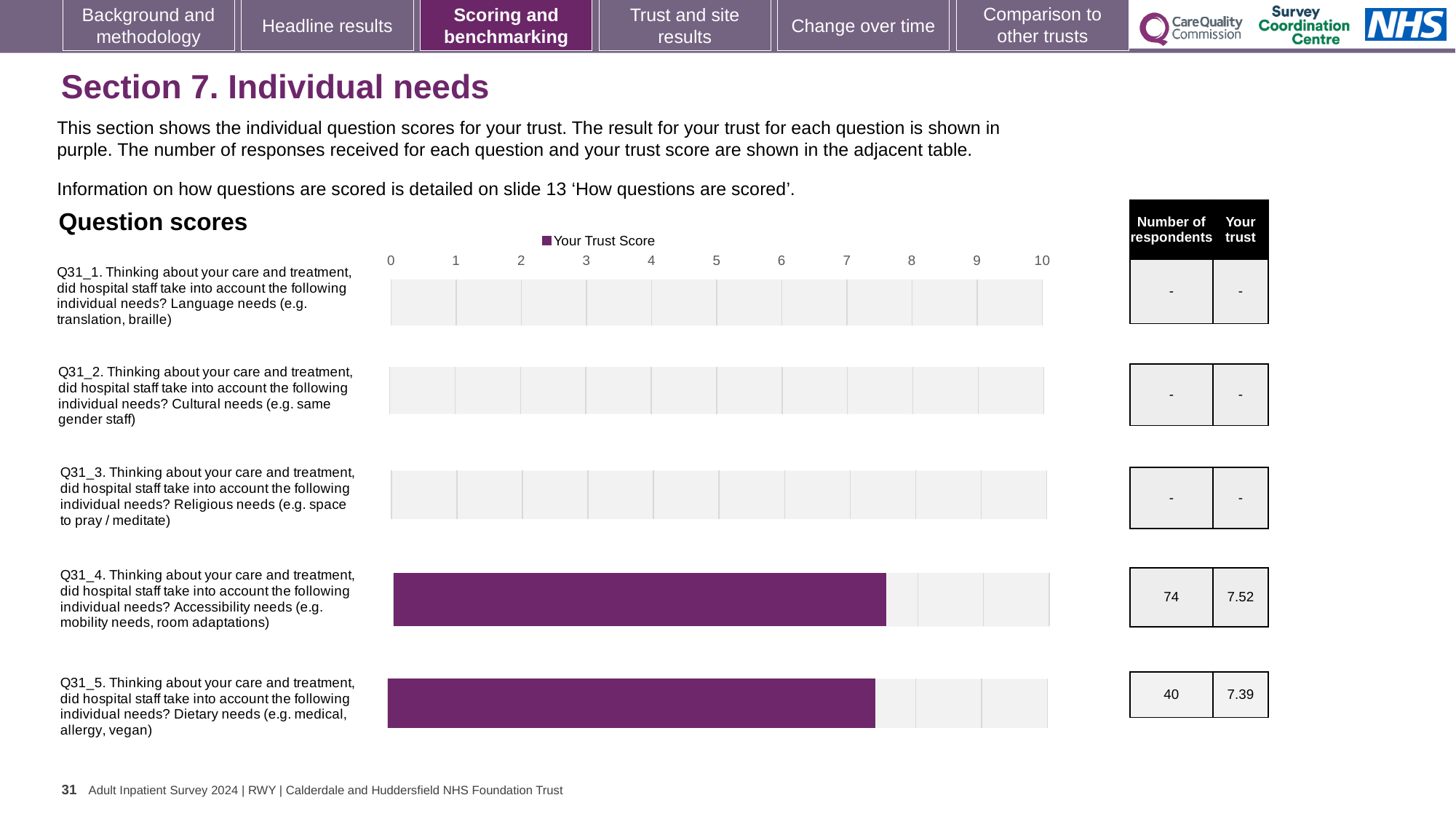
Is the trust score for Q31_4 (Accessibility needs) greater or less than 7? greater Is the trust score for Q31_5 (Dietary needs) greater or less than 8? less What is the trust score for Q31_5 (Dietary needs)? 7.39 How many series does the chart legend list? 1 How many questions are listed in the Question scores chart? 5 What is the name of the series shown in the chart legend? Your Trust Score Which question has the higher trust score, Q31_4 or Q31_5? Q31_4 How many respondents answered Q31_4 (Accessibility needs)? 74 What is the difference between the trust scores for Q31_4 and Q31_5? 0.13 How many respondents answered Q31_5 (Dietary needs)? 40 What is the trust score for Q31_4 (Accessibility needs)? 7.52 What kind of chart is used to show the question scores? Bar chart